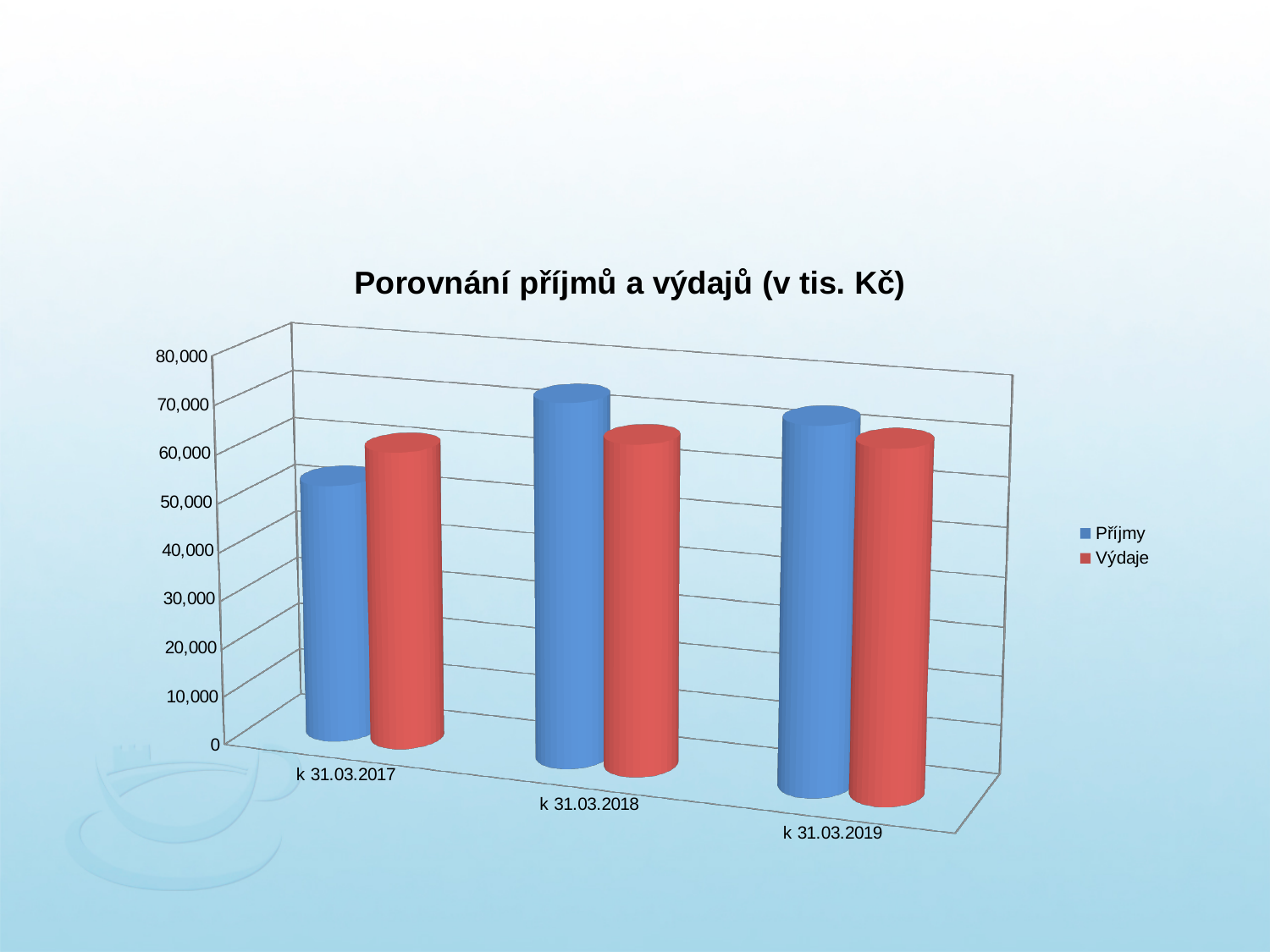
Is the value of Příjmy for k 31.03.2018 greater or less than 50,000? greater Which series is shown in red? Výdaje For k 31.03.2017, which is larger, Příjmy or Výdaje? Výdaje Is the value of Příjmy for k 31.03.2017 greater or less than 60,000? less What kind of chart is shown on the slide? Bar chart How many categories are shown on the x axis? 3 Does Příjmy rise or fall from k 31.03.2017 to k 31.03.2018? rise How many series does the legend list? 2 Is the value of Výdaje for k 31.03.2018 greater or less than 40,000? greater What is the title of the chart? Porovnání příjmů a výdajů (v tis. Kč) For k 31.03.2018, which is larger, Příjmy or Výdaje? Příjmy For which category is Příjmy lowest? k 31.03.2017